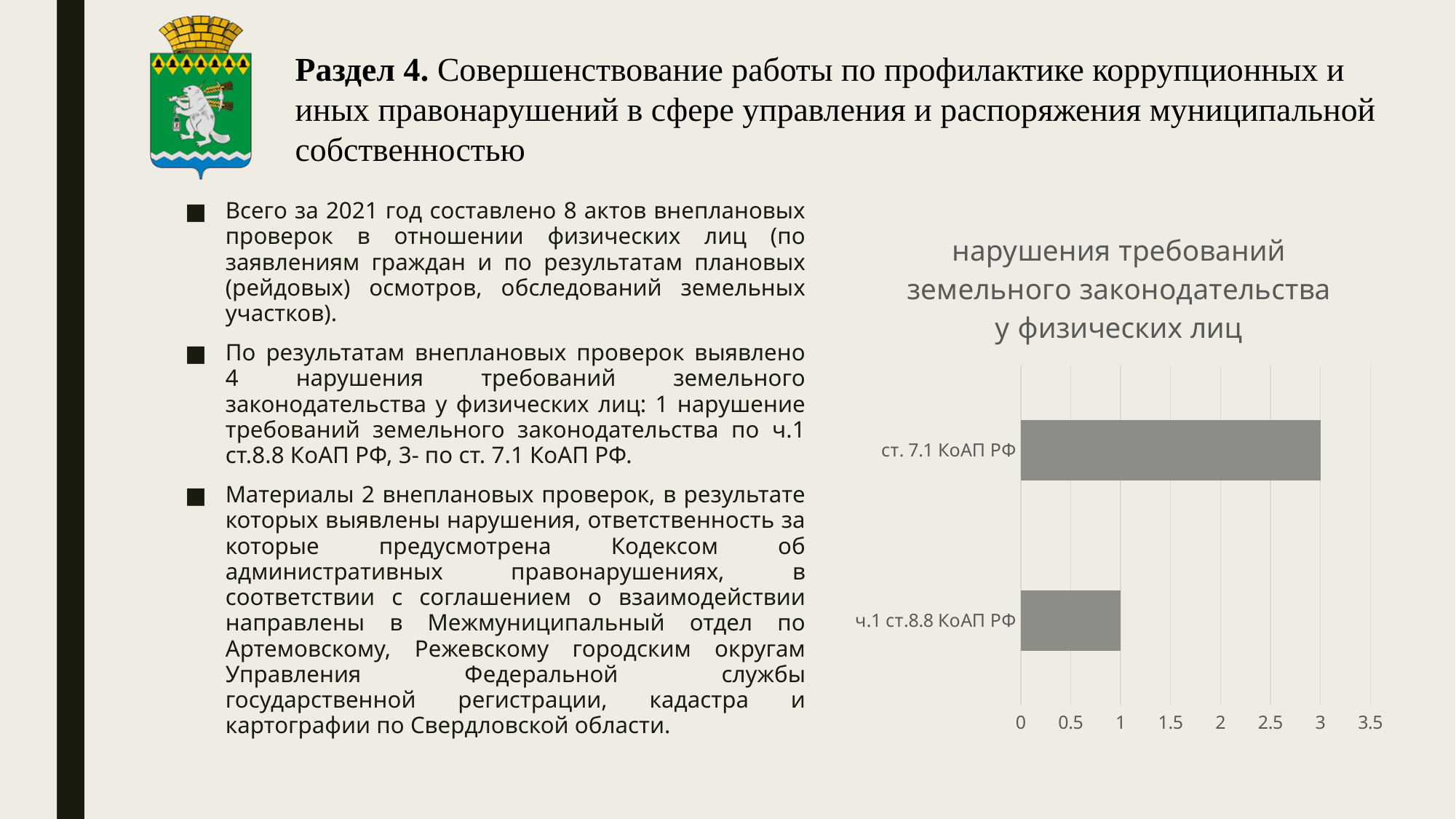
Is the value for ч.1 ст.8.8 КоАП РФ greater or less than 2? less What is the title of the chart? нарушения требований земельного законодательства у физических лиц What is the maximum value shown on the horizontal axis of the chart? 3.5 How many categories does the chart show? 2 Which is larger: the value for ст. 7.1 КоАП РФ or the value for ч.1 ст.8.8 КоАП РФ? ст. 7.1 КоАП РФ Which category has the lowest value? ч.1 ст.8.8 КоАП РФ What type of chart is shown on the slide? bar chart What is the difference between the values for ст. 7.1 КоАП РФ and ч.1 ст.8.8 КоАП РФ? 2 What is the value for ст. 7.1 КоАП РФ? 3 Which category has the highest value? ст. 7.1 КоАП РФ Is the value for ст. 7.1 КоАП РФ greater or less than 2? greater What is the value for ч.1 ст.8.8 КоАП РФ? 1